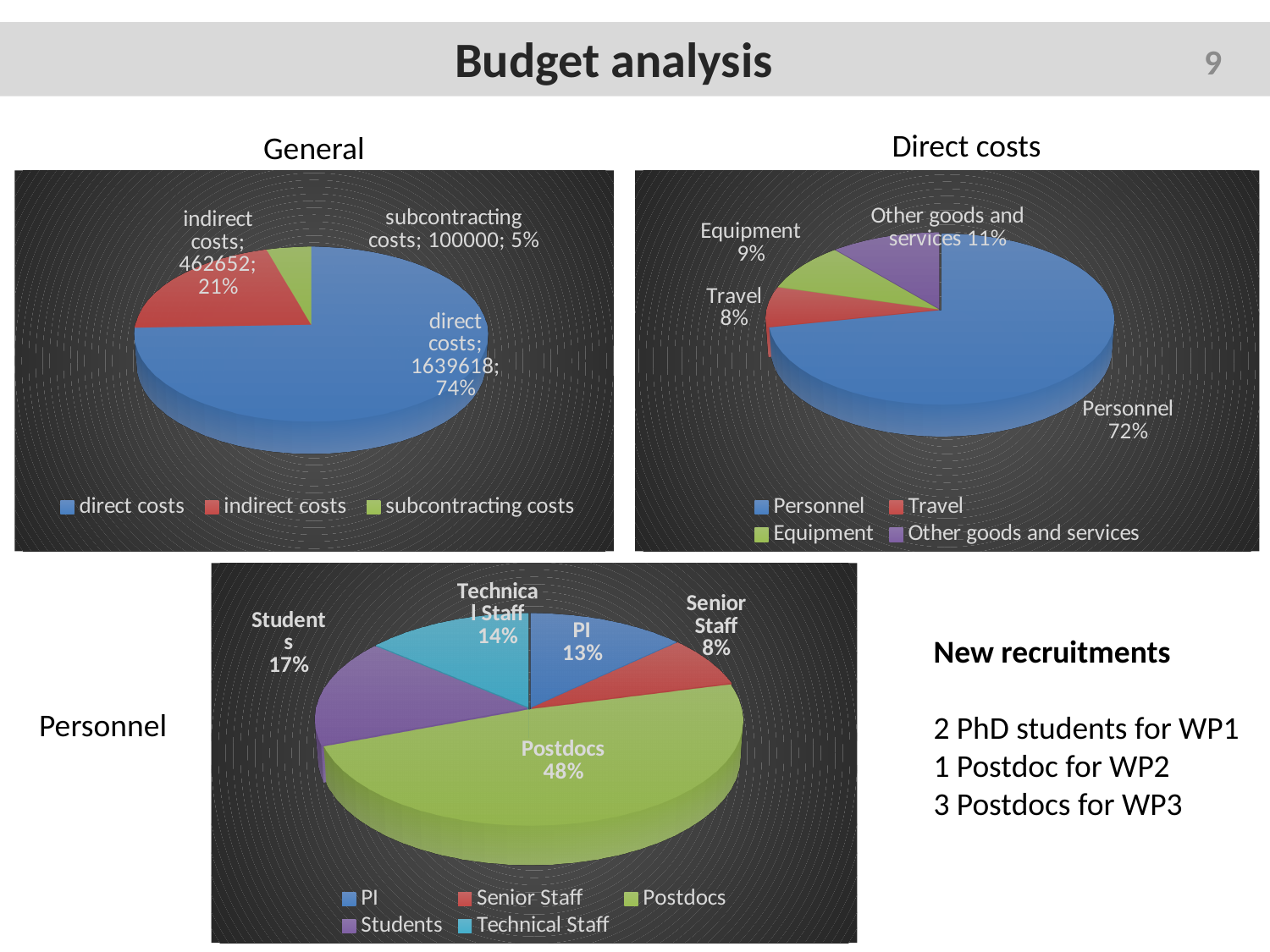
In the General chart, what is the difference between the direct costs value and the indirect costs value? 1176966 In the Direct costs chart, what share of the pie is Personnel? 72% In the Personnel chart, which category has the smallest share? Senior Staff In the General chart, what share of the pie is subcontracting costs? 5% In the Personnel chart, what share of the pie is Postdocs? 48% In the Personnel chart, what is the difference in percentage points between Students and Technical Staff? 3 In the Direct costs chart, which is larger, Equipment or Other goods and services? Other goods and services In the General chart, what is the value shown for direct costs? 1639618; 74% In the General chart, how many slices does the pie have? 3 In the Direct costs chart, how many entries does the legend list? 4 In the Direct costs chart, which category has the smallest share? Travel What kind of chart is the Personnel chart? Pie chart